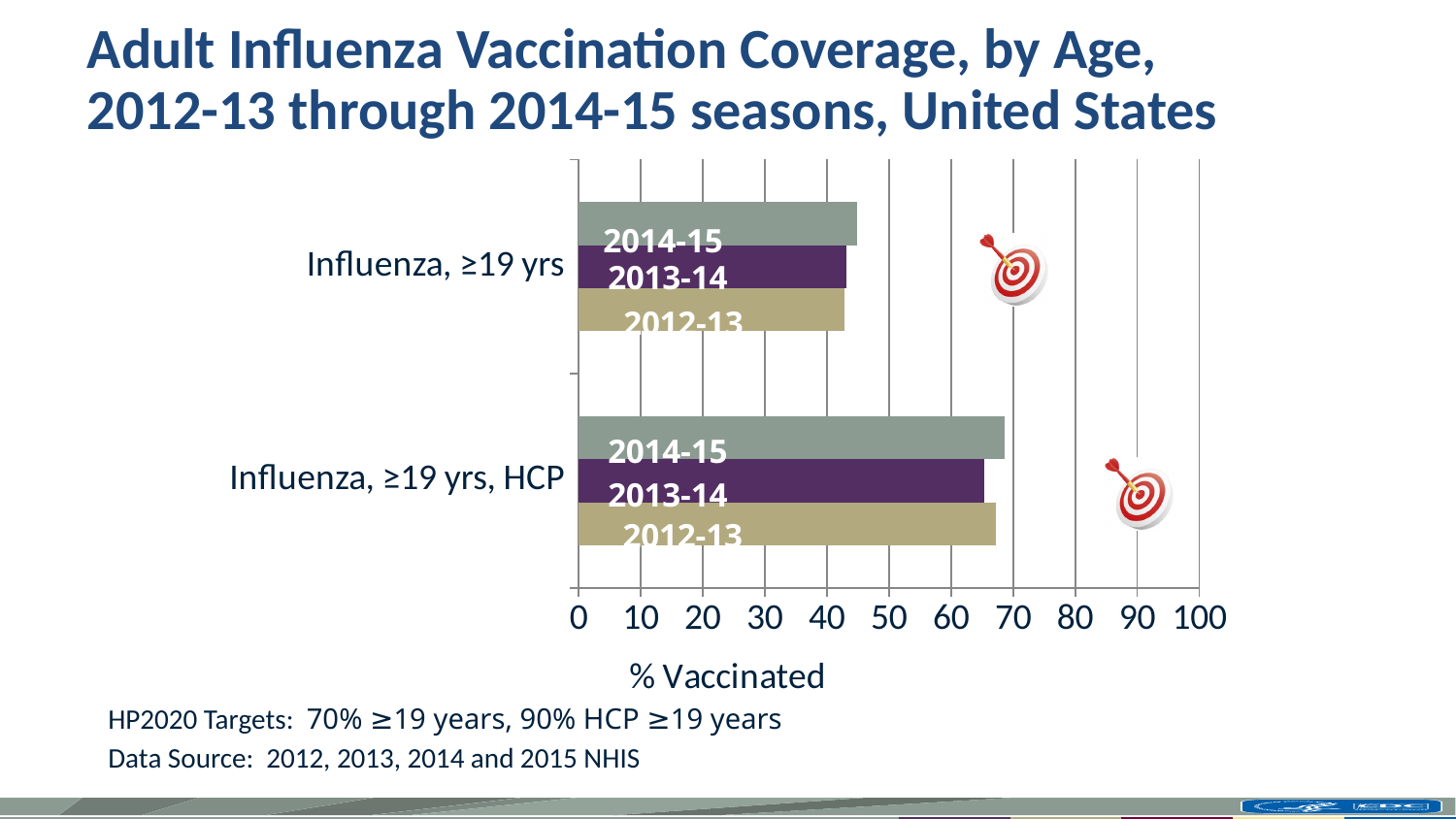
Is the 2014-15 value for Influenza, ≥19 yrs greater or less than 50? less Is the 2012-13 value for Influenza, ≥19 yrs greater or less than 50? less How many age categories are plotted on the chart? 2 Is the 2014-15 value for Influenza, ≥19 yrs, HCP greater or less than 60? greater What is the title of the x axis? % Vaccinated What is the HP2020 target for HCP ≥19 years stated on the slide? 90% Which category has the higher 2014-15 vaccination coverage: Influenza, ≥19 yrs or Influenza, ≥19 yrs, HCP? Influenza, ≥19 yrs, HCP What kind of chart is shown on the slide? bar chart How many seasons (series) are plotted for each category? 3